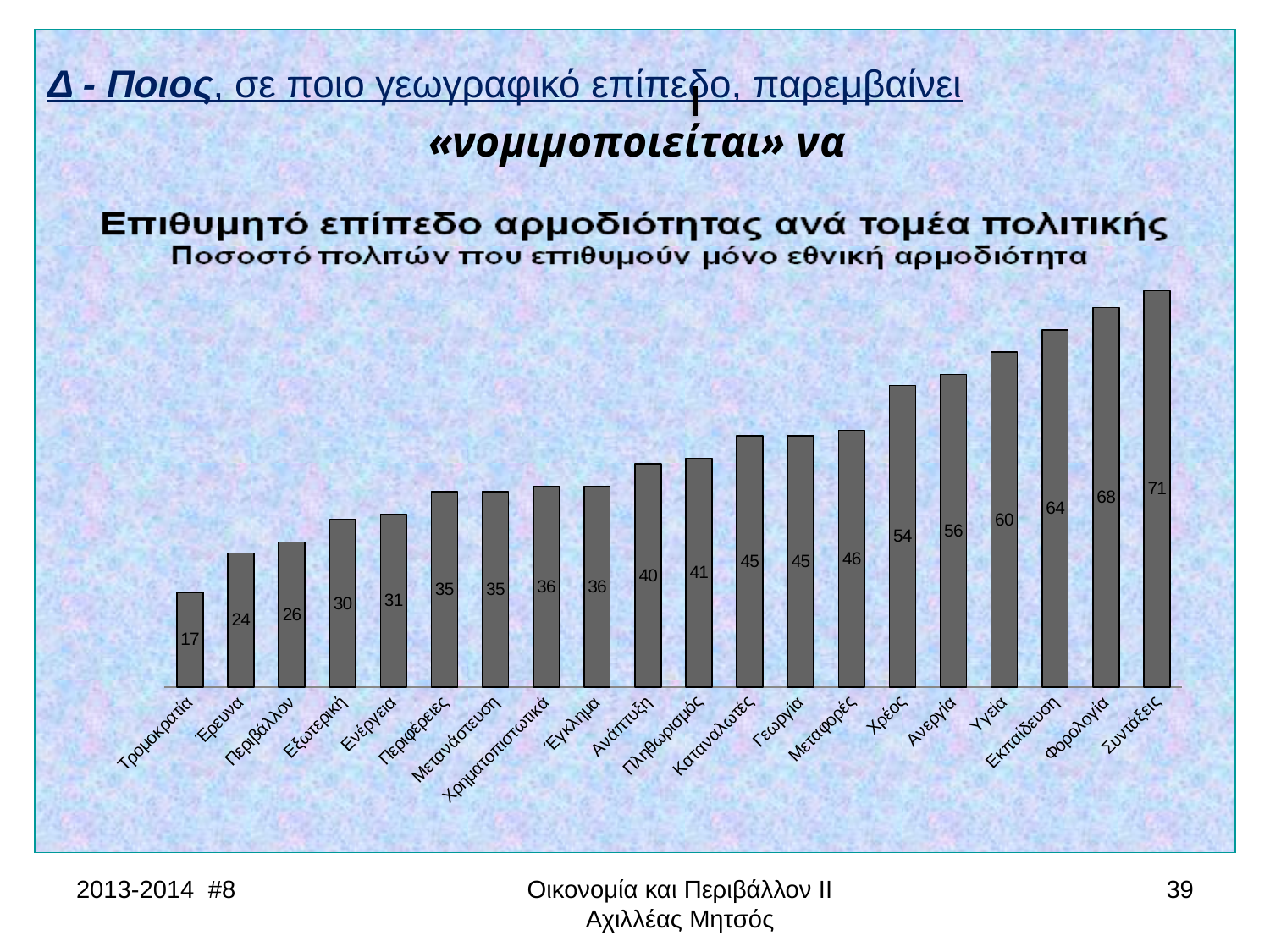
What is the value for Υγεία? 60 Which category has the highest value? Συντάξεις Which is larger, the value for Ανεργία or the value for Μεταφορές? Ανεργία What is the difference between the values for Φορολογία and Χρέος? 14 Do the values rise or fall from left to right along the x axis? Rise What is the value for Πληθωρισμός? 41 What is the subtitle printed under the chart title? Ποσοστό πολιτών που επιθυμούν μόνο εθνική αρμοδιότητα How many categories are shown in the chart? 20 Which category has the lowest value? Τρομοκρατία What is the value for Τρομοκρατία? 17 What is the difference between the values for Συντάξεις and Τρομοκρατία? 54 What kind of chart is shown on the slide? Bar chart